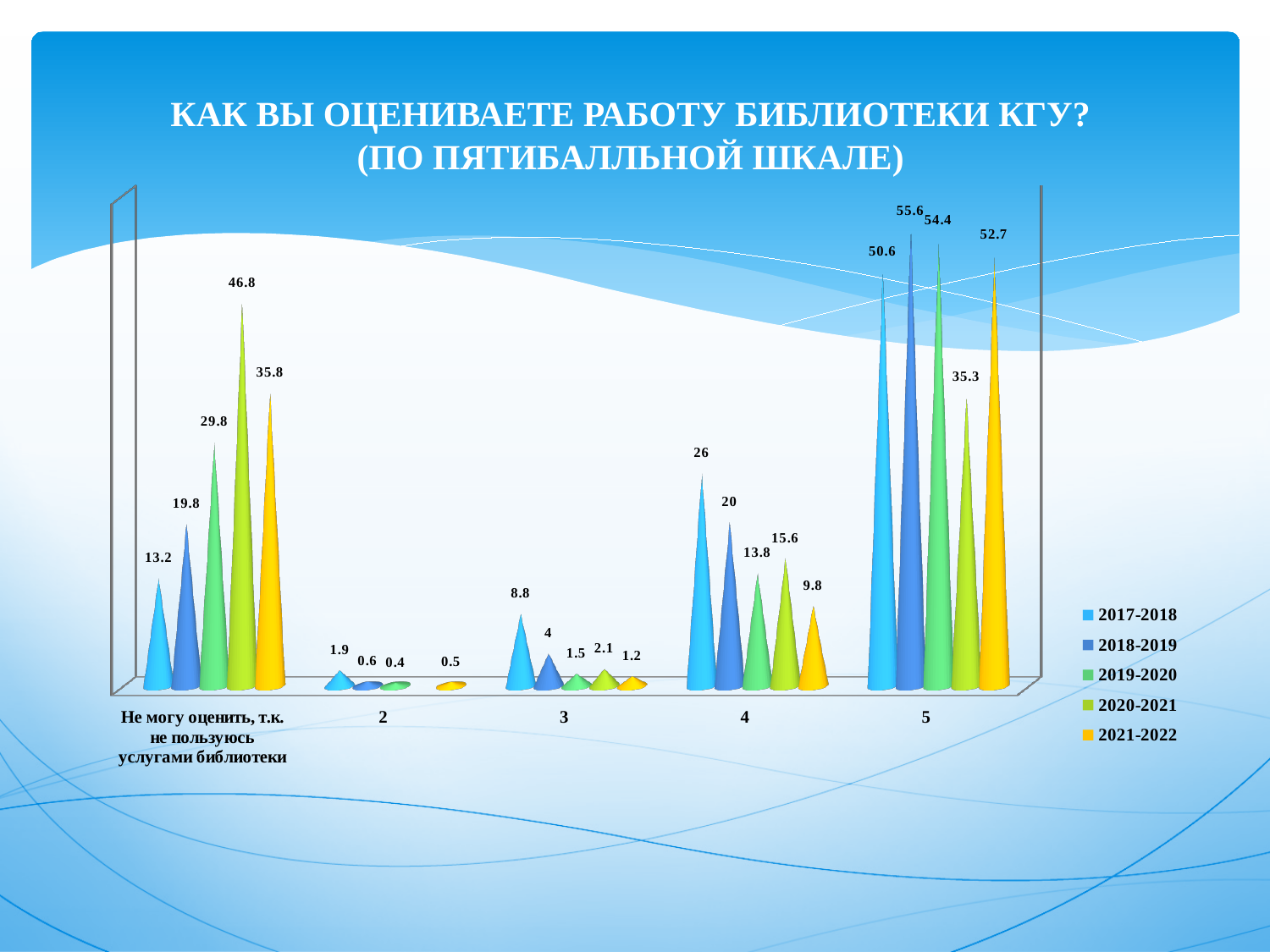
What kind of chart is shown on the slide? bar chart Which series has the lowest value in category 4? 2021-2022 What is the value for 2020-2021 in the category "Не могу оценить, т.к. не пользуюсь услугами библиотеки"? 46.8 How many series does the legend list? 5 Which is larger in category 5: the 2019-2020 value or the 2020-2021 value? 2019-2020 What is the value for 2018-2019 in category 3? 4 What is the value for 2017-2018 in category 5? 50.6 Which series has the highest value in category 5? 2018-2019 What is the value for 2021-2022 in category 4? 9.8 What is the difference between the 2017-2018 and 2018-2019 values in category 4? 6 How many categories are shown on the x axis? 5 What is the title of the chart? КАК ВЫ ОЦЕНИВАЕТЕ РАБОТУ БИБЛИОТЕКИ КГУ? (ПО ПЯТИБАЛЛЬНОЙ ШКАЛЕ)